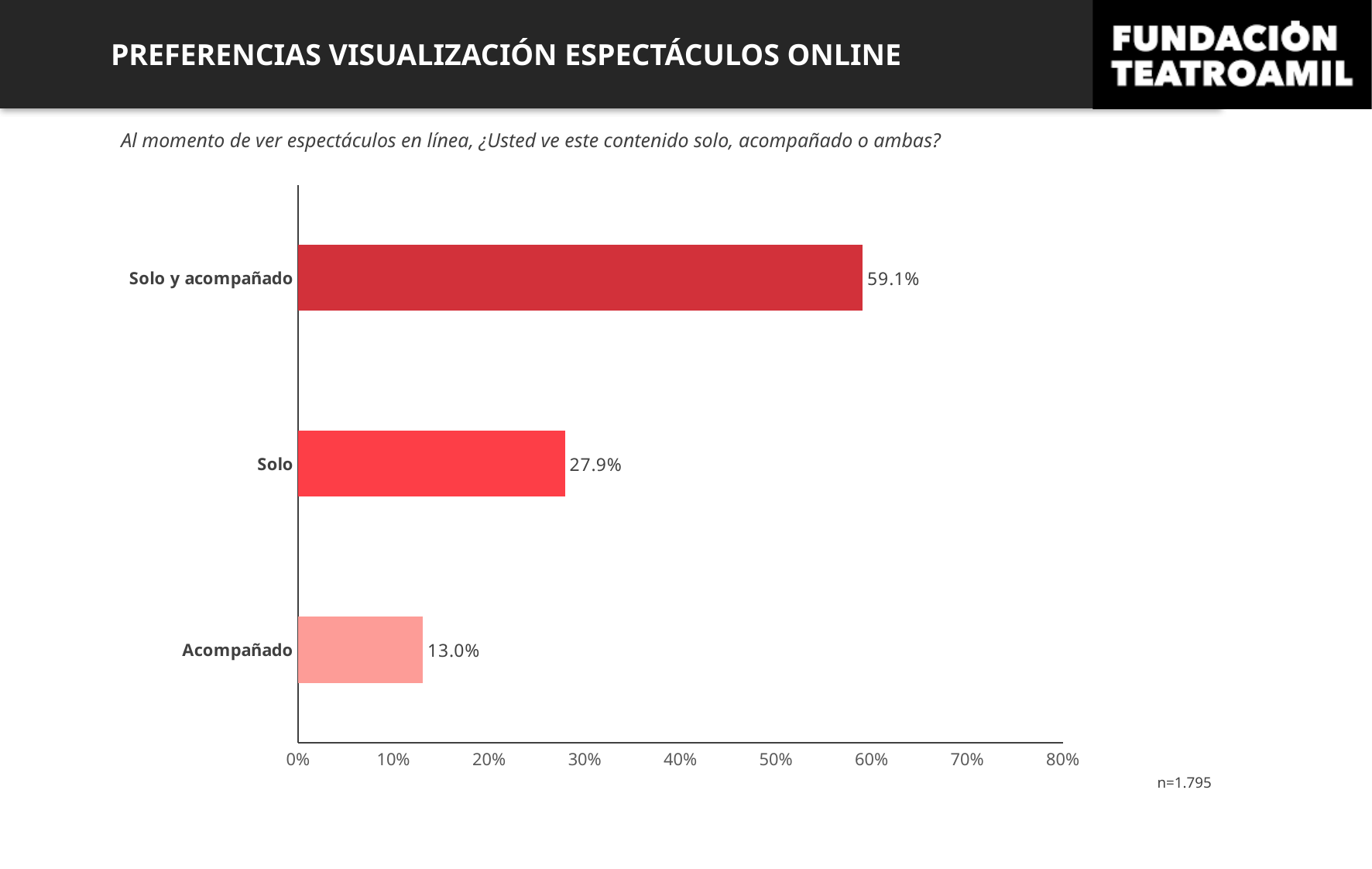
What is the sample size (n) noted below the chart? n=1.795 What is the value for "Solo y acompañado"? 59.1% What is the difference between the values for "Solo y acompañado" and "Solo"? 31.2% How many categories are shown in the chart? 3 Is the value for "Solo y acompañado" greater or less than 50%? greater Which is larger, the value for "Solo" or the value for "Acompañado"? Solo What is the value for "Solo"? 27.9% Which category has the highest value? Solo y acompañado What is the difference between the values for "Solo" and "Acompañado"? 14.9% What is the value for "Acompañado"? 13.0% What kind of chart is shown on the slide? Bar chart Which category has the lowest value? Acompañado